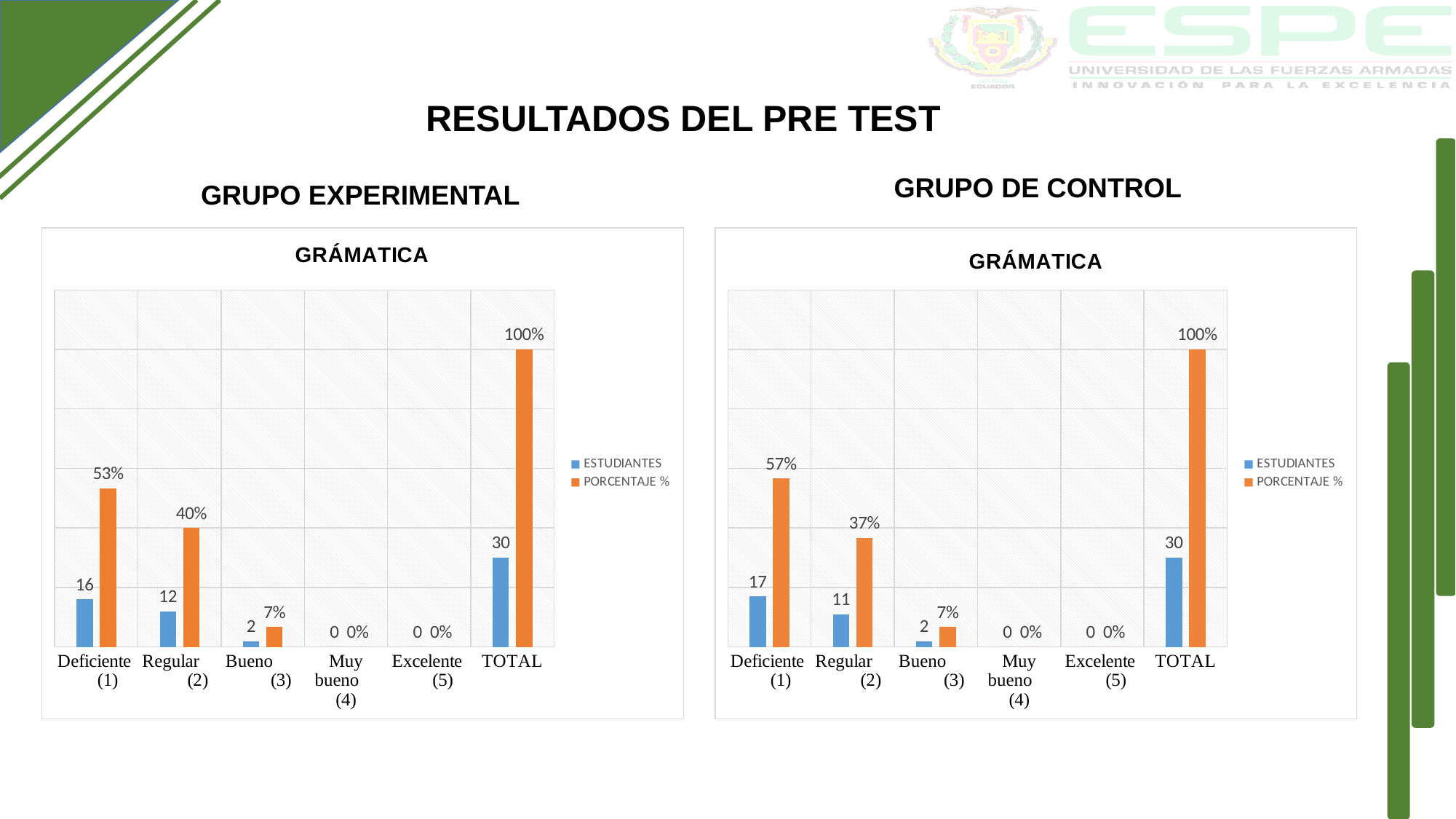
In the GRUPO DE CONTROL chart, what is the PORCENTAJE % value for Deficiente (1)? 57% How many categories are shown on the x axis of the GRUPO DE CONTROL chart? 6 In the GRUPO EXPERIMENTAL chart, what is the PORCENTAJE % value for Regular (2)? 40% How many series does the legend of the GRUPO EXPERIMENTAL chart list? 2 In the GRUPO DE CONTROL chart, what is the difference in ESTUDIANTES between Deficiente (1) and Regular (2)? 6 In the GRUPO EXPERIMENTAL chart, excluding TOTAL, which category has the highest ESTUDIANTES value? Deficiente (1) Which is larger: the Deficiente (1) ESTUDIANTES value in the GRUPO EXPERIMENTAL chart or in the GRUPO DE CONTROL chart? GRUPO DE CONTROL In the GRUPO DE CONTROL chart, what is the ESTUDIANTES value for Regular (2)? 11 In the GRUPO EXPERIMENTAL chart, what is the ESTUDIANTES value for Deficiente (1)? 16 In the GRUPO EXPERIMENTAL chart, what is the difference in ESTUDIANTES between Deficiente (1) and Regular (2)? 4 What is the title shown inside the GRUPO EXPERIMENTAL chart? GRÁMATICA What type of chart is the GRUPO DE CONTROL chart? Bar chart